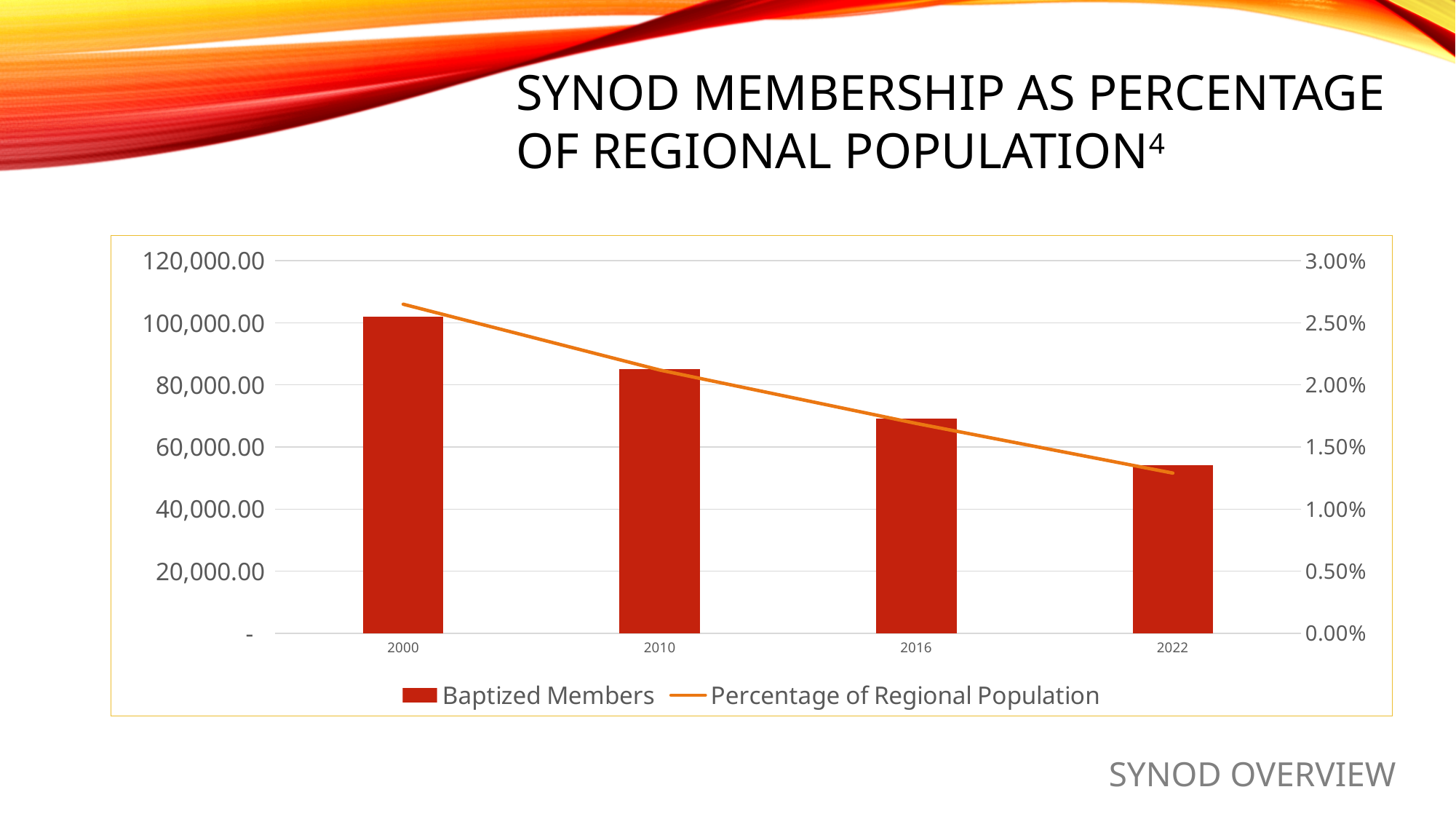
How many series does the chart's legend list? 2 Is the number of Baptized Members in 2000 greater or less than 100,000.00? greater Is the number of Baptized Members in 2022 greater or less than 60,000.00? less Do the Baptized Members values rise or fall from 2000 to 2022? fall Which year has more Baptized Members, 2010 or 2016? 2010 What is the title of the chart on the slide? Synod Membership as Percentage of Regional Population Which year has the highest number of Baptized Members? 2000 How many years are shown on the x axis of the chart? 4 Is the Percentage of Regional Population in 2010 greater or less than 2.00%? greater Which year has the lowest number of Baptized Members? 2022 What kind of chart is shown on the slide? A combined bar and line chart Which year has the lowest Percentage of Regional Population? 2022